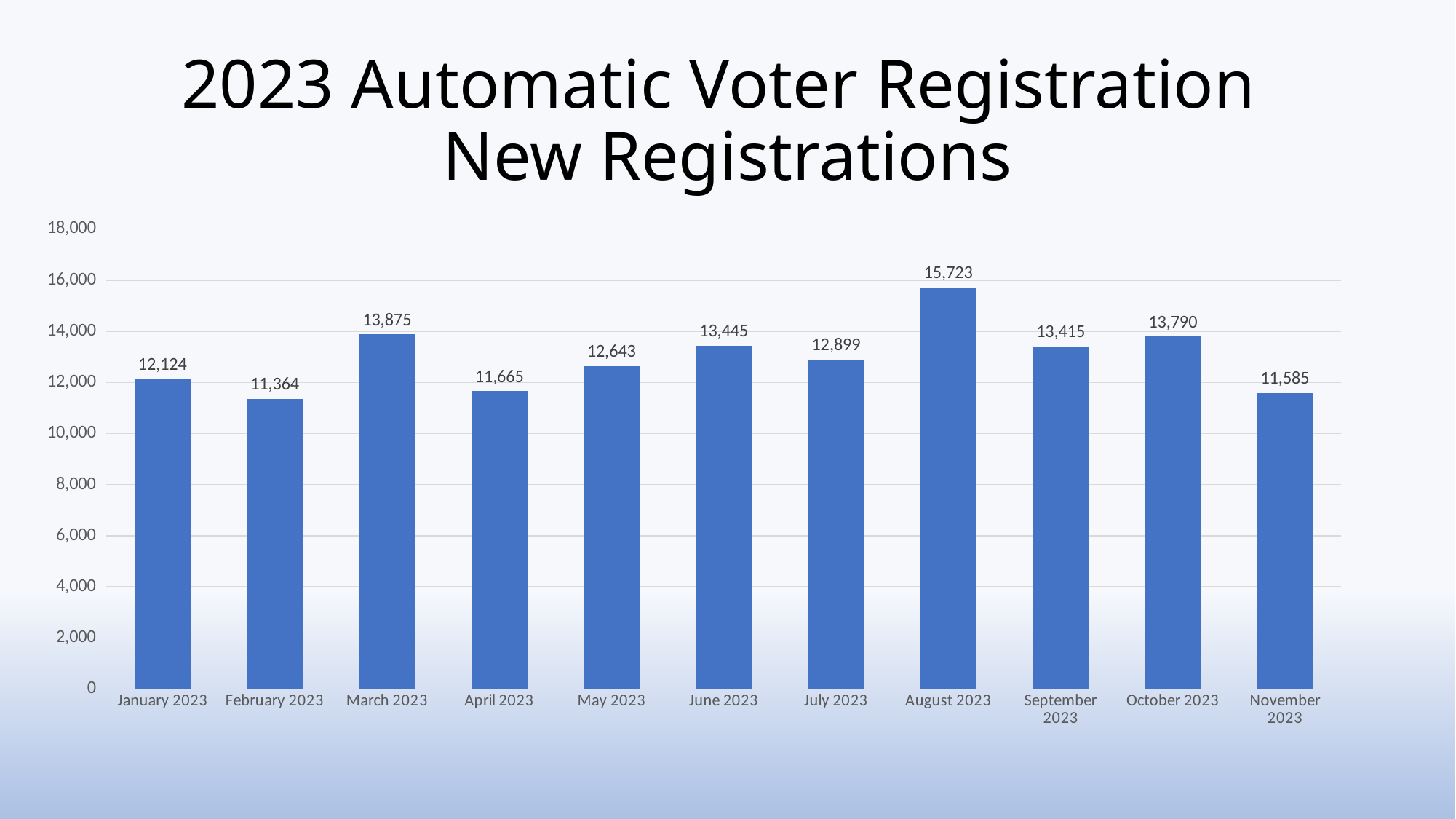
Is the value for November 2023 greater or less than 12,000? less Do the values rise or fall from January 2023 to February 2023? fall Which month has the lowest value? February 2023 Which month has the highest value? August 2023 How many months are shown on the x axis? 11 What is the difference between the values for March 2023 and April 2023? 2,210 Which is larger, the value for June 2023 or the value for October 2023? October 2023 What is the title of the chart? 2023 Automatic Voter Registration New Registrations What is the difference between the values for August 2023 and July 2023? 2,824 What is the value for March 2023? 13,875 What kind of chart is shown on the slide? bar chart What is the value for September 2023? 13,415